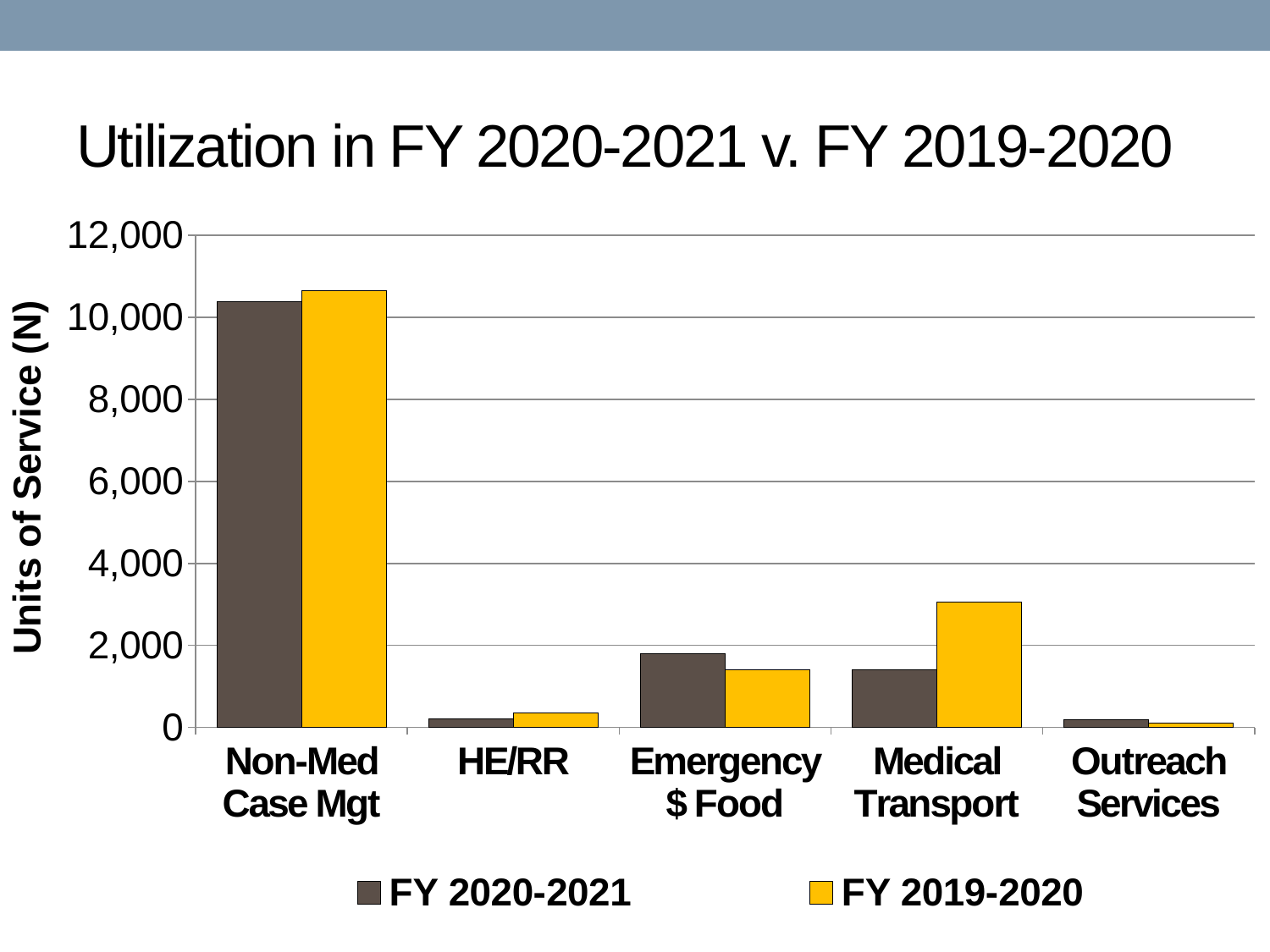
For Emergency $ Food, which series has the larger value, FY 2020-2021 or FY 2019-2020? FY 2020-2021 How many series does the legend list? 2 Is the FY 2020-2021 value for Non-Med Case Mgt greater or less than 10,000? greater What is the label on the vertical axis of the chart? Units of Service (N) Is the FY 2019-2020 value for Medical Transport greater or less than 2,000? greater Which category has the highest value for FY 2020-2021? Non-Med Case Mgt What kind of chart is shown on the slide? Bar chart Which category has the lowest value for FY 2019-2020? Outreach Services Is the FY 2020-2021 value for Emergency $ Food greater or less than 2,000? less For HE/RR, which series has the larger value, FY 2020-2021 or FY 2019-2020? FY 2019-2020 How many service categories are shown on the x axis? 5 For Medical Transport, which series has the larger value, FY 2020-2021 or FY 2019-2020? FY 2019-2020